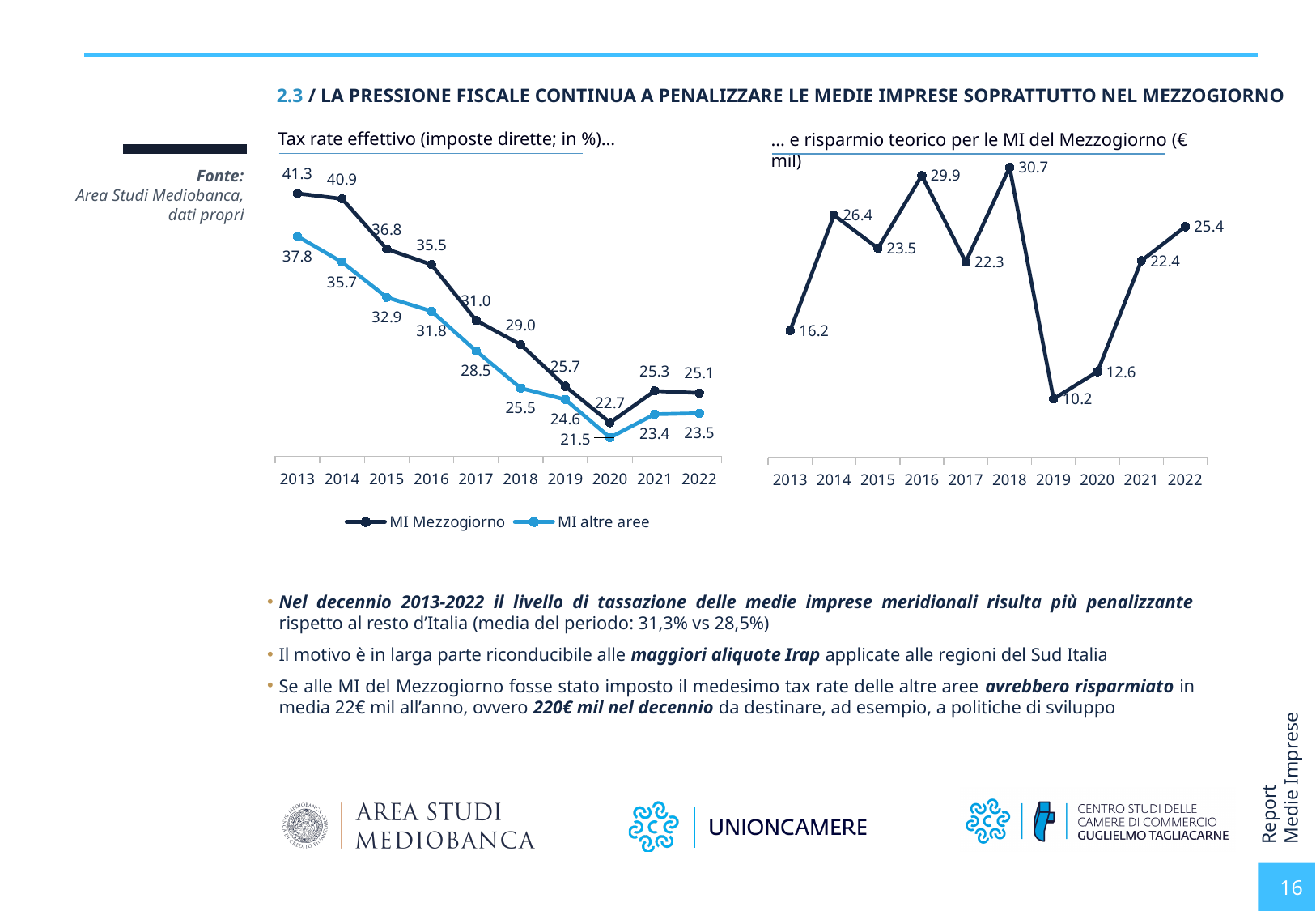
In the right chart (risparmio teorico), which year has the highest value? 2018 In the left chart (Tax rate effettivo), does the MI Mezzogiorno series generally rise or fall from 2013 to 2020? Fall What kind of chart is the left chart (Tax rate effettivo)? Line chart In the left chart (Tax rate effettivo), which series has the higher value in 2017, MI Mezzogiorno or MI altre aree? MI Mezzogiorno In the right chart (risparmio teorico), what is the value for 2018? 30.7 In the right chart (risparmio teorico), which year has the lowest value? 2019 How many years are plotted on the x axis of the right chart (risparmio teorico)? 10 In the right chart (risparmio teorico), what is the difference between the 2018 and 2019 values? 20.5 In the left chart (Tax rate effettivo), what is the value for MI Mezzogiorno in 2013? 41.3 In the left chart (Tax rate effettivo), what is the value for MI altre aree in 2020? 21.5 In the left chart (Tax rate effettivo), what is the difference between MI Mezzogiorno and MI altre aree in 2015? 3.9 How many series does the legend of the left chart (Tax rate effettivo) list? 2